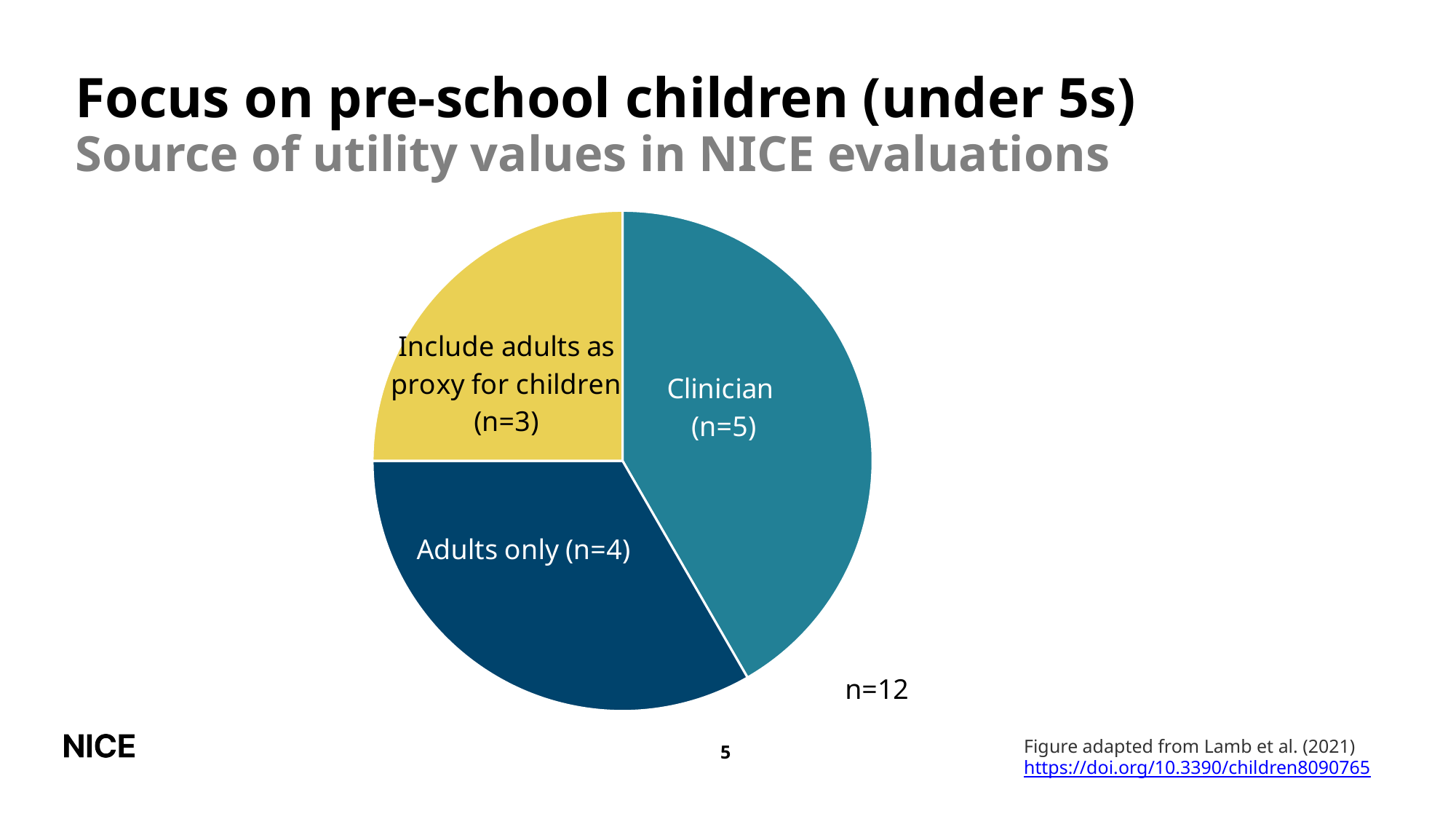
What kind of chart is shown on the slide? pie chart What is the value for the Clinician slice? n=5 What is the value for the 'Include adults as proxy for children' slice? n=3 What colour is the Clinician slice? teal Which is larger, the Adults only slice or the 'Include adults as proxy for children' slice? Adults only What is the total n shown for the pie chart? n=12 What is the difference between the Clinician value and the Adults only value? 1 What is the value for the Adults only slice? n=4 Which category has the largest slice of the pie? Clinician What is the difference between the Clinician value and the 'Include adults as proxy for children' value? 2 How many slices does the pie chart have? 3 Which category has the smallest slice of the pie? Include adults as proxy for children